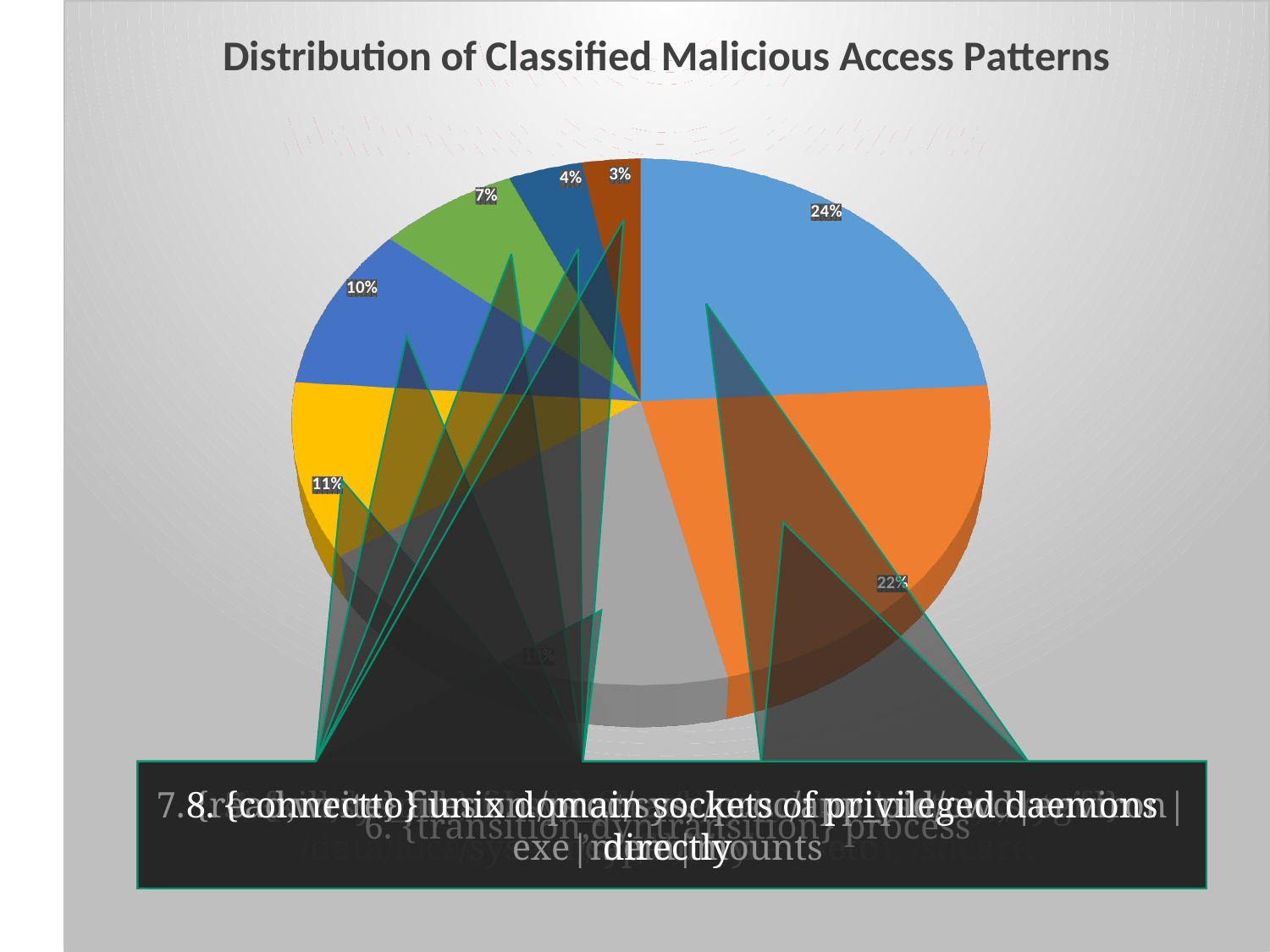
Which slice is larger, the light blue slice labelled 24% or the orange slice labelled 22%? the light blue slice (24%) What kind of chart is shown on the slide? pie chart What is the percentage of the largest slice of the pie? 24% What is the difference in percentage points between the 10% slice and the 4% slice? 6 What is the percentage of the smallest slice of the pie? 3% How many slices does the pie chart have? 8 What share of the pie does the green slice represent? 7% What is the title of the chart? Distribution of Classified Malicious Access Patterns What share of the pie does the yellow slice represent? 11% What is the difference in percentage points between the largest slice (24%) and the second largest slice (22%)? 2 What colour is the largest slice of the pie? light blue What share of the pie does the orange slice represent? 22%